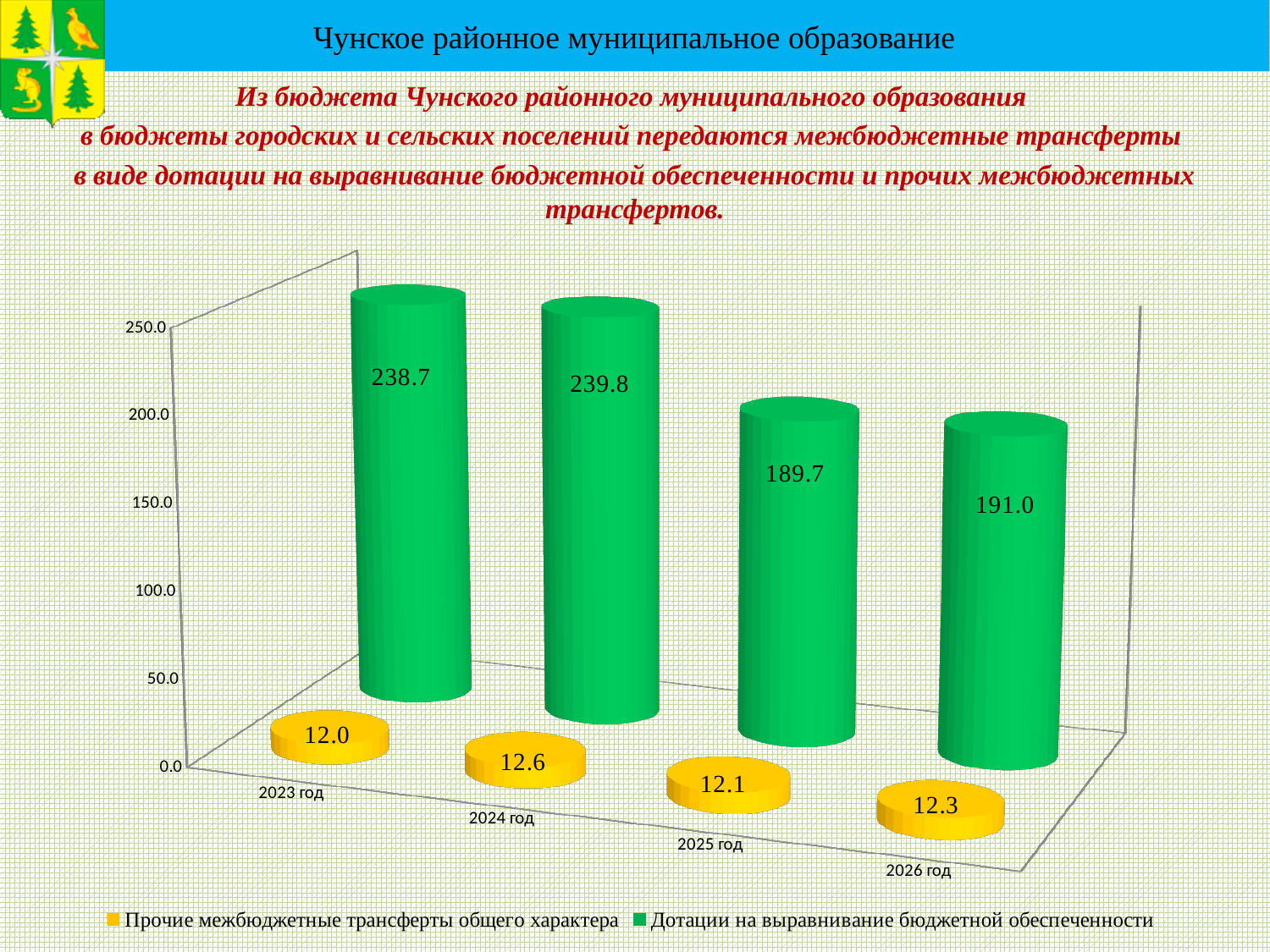
What is the difference between Дотации на выравнивание бюджетной обеспеченности in 2024 год and 2025 год? 50.1 Which colour represents Прочие межбюджетные трансферты общего характера in the chart? yellow How many years are shown on the x axis of the chart? 4 What is the value of Дотации на выравнивание бюджетной обеспеченности for 2026 год? 191.0 Which is larger: Дотации на выравнивание бюджетной обеспеченности in 2023 год or in 2026 год? 2023 год What kind of chart is shown on the slide? bar chart What is the value of Прочие межбюджетные трансферты общего характера for 2024 год? 12.6 In which year is Дотации на выравнивание бюджетной обеспеченности the lowest? 2025 год In which year is Прочие межбюджетные трансферты общего характера the highest? 2024 год How many series does the legend list? 2 What is the value of Дотации на выравнивание бюджетной обеспеченности for 2023 год? 238.7 What is the value of Прочие межбюджетные трансферты общего характера for 2025 год? 12.1